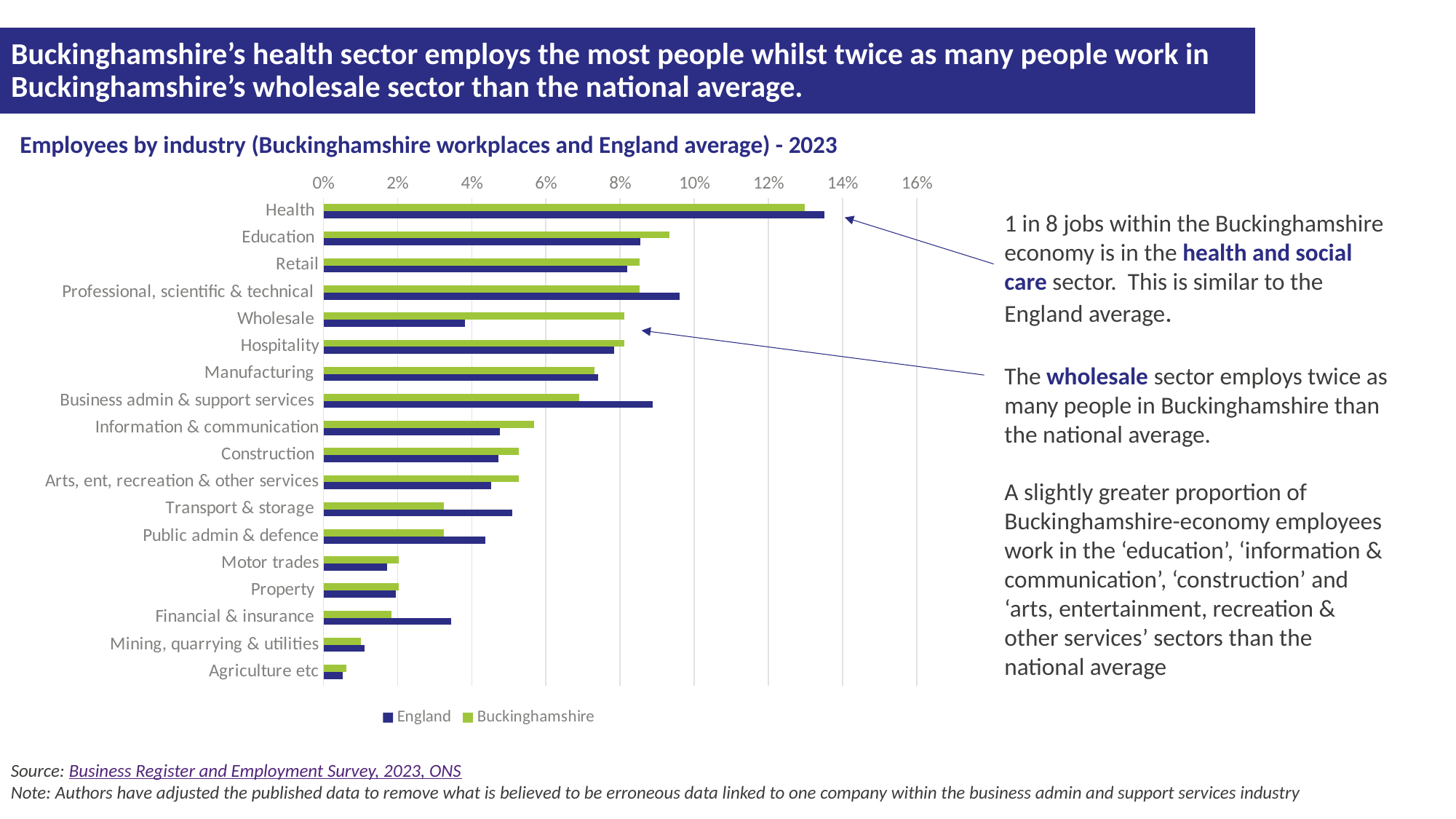
Is the England value for Health greater or less than 12%? greater Is the Buckinghamshire value for Financial & insurance greater or less than 2%? less Which industry has the highest Buckinghamshire value? Health What kind of chart is shown on the slide? Bar chart Is the Buckinghamshire value for Wholesale greater or less than 6%? greater Which industry has the lowest Buckinghamshire value? Agriculture etc For Transport & storage, which is larger: the England value or the Buckinghamshire value? England For Business admin & support services, which is larger: the England value or the Buckinghamshire value? England How many series does the chart legend list? 2 Which colour represents Buckinghamshire in the chart? Green How many industry categories are shown on the chart? 18